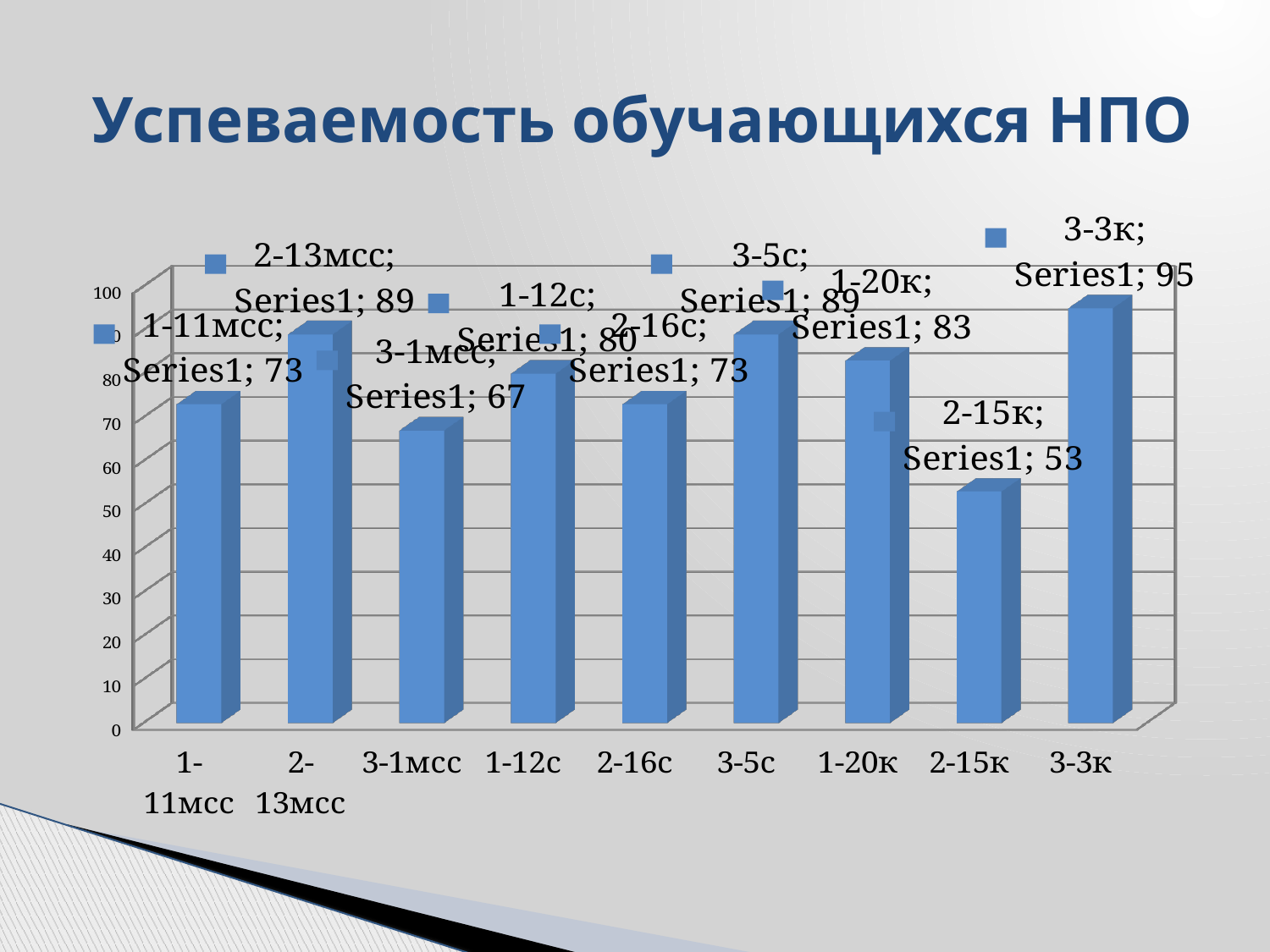
Which category has the highest value? 3-3к What kind of chart is shown on the slide? bar chart What is the value for 1-20к? 83 What is the value for 1-11мсс? 73 How many categories are shown on the chart? 9 What is the title of the chart on the slide? Успеваемость обучающихся НПО Which is larger, the value for 2-13мсс or the value for 3-1мсс? 2-13мсс Is the value for 2-15к greater or less than 60? less Which category has the lowest value? 2-15к What is the value for 3-1мсс? 67 What is the value for 1-12с? 80 What is the difference between the values for 3-3к and 2-15к? 42